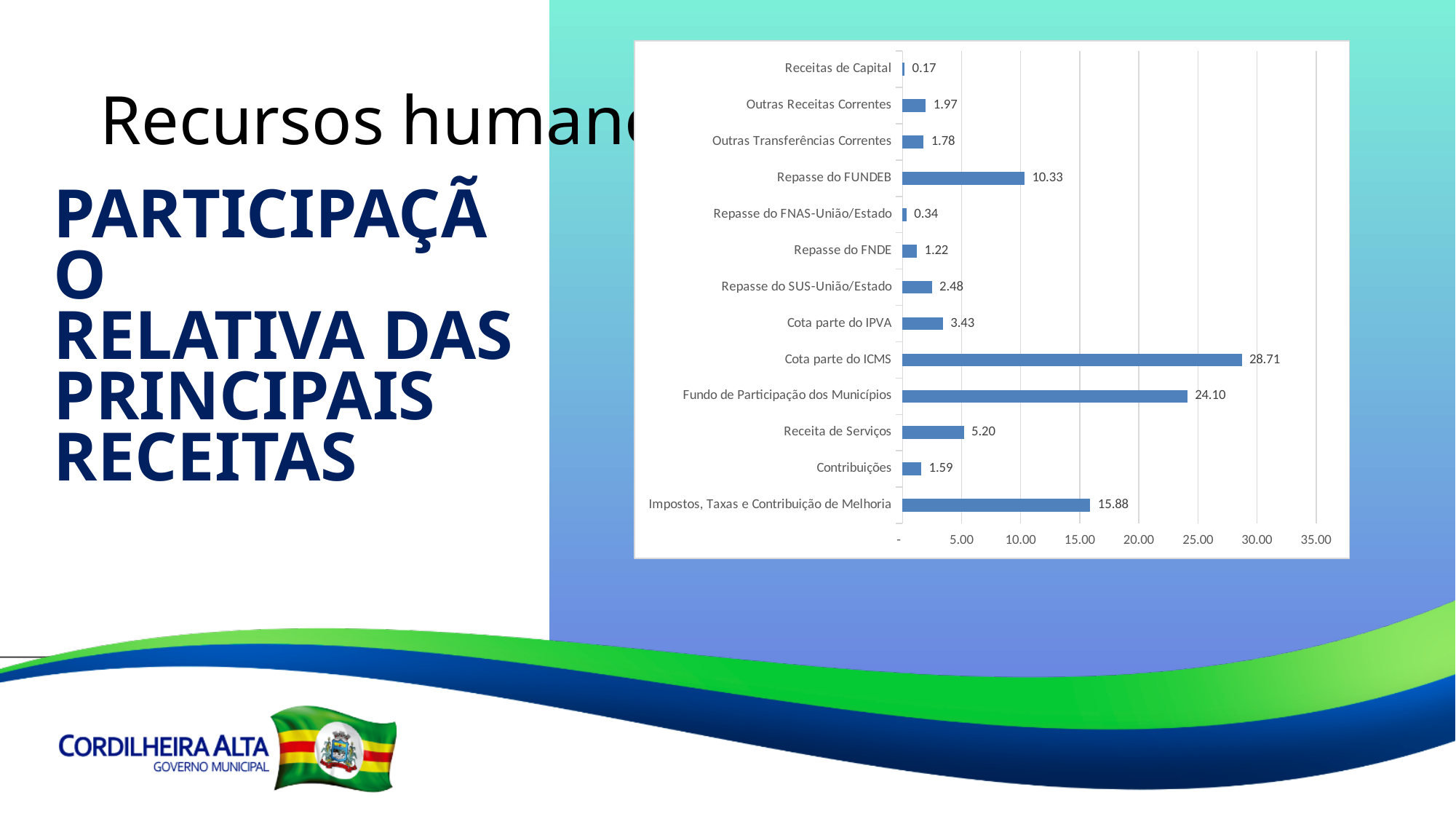
What is the value for Impostos, Taxas e Contribuição de Melhoria? 15.88 What is the difference between Cota parte do ICMS and Fundo de Participação dos Municípios? 4.61 What kind of chart is shown on the slide? bar chart What is the value for Cota parte do ICMS? 28.71 Which category has the lowest value? Receitas de Capital Is the value for Fundo de Participação dos Municípios greater or less than 20.00? greater What is the difference between Repasse do FUNDEB and Receita de Serviços? 5.13 Which is larger, Receita de Serviços or Cota parte do IPVA? Receita de Serviços What is the value for Repasse do FUNDEB? 10.33 How many categories are shown in the chart? 13 Which category has the highest value? Cota parte do ICMS What is the value for Repasse do SUS-União/Estado? 2.48